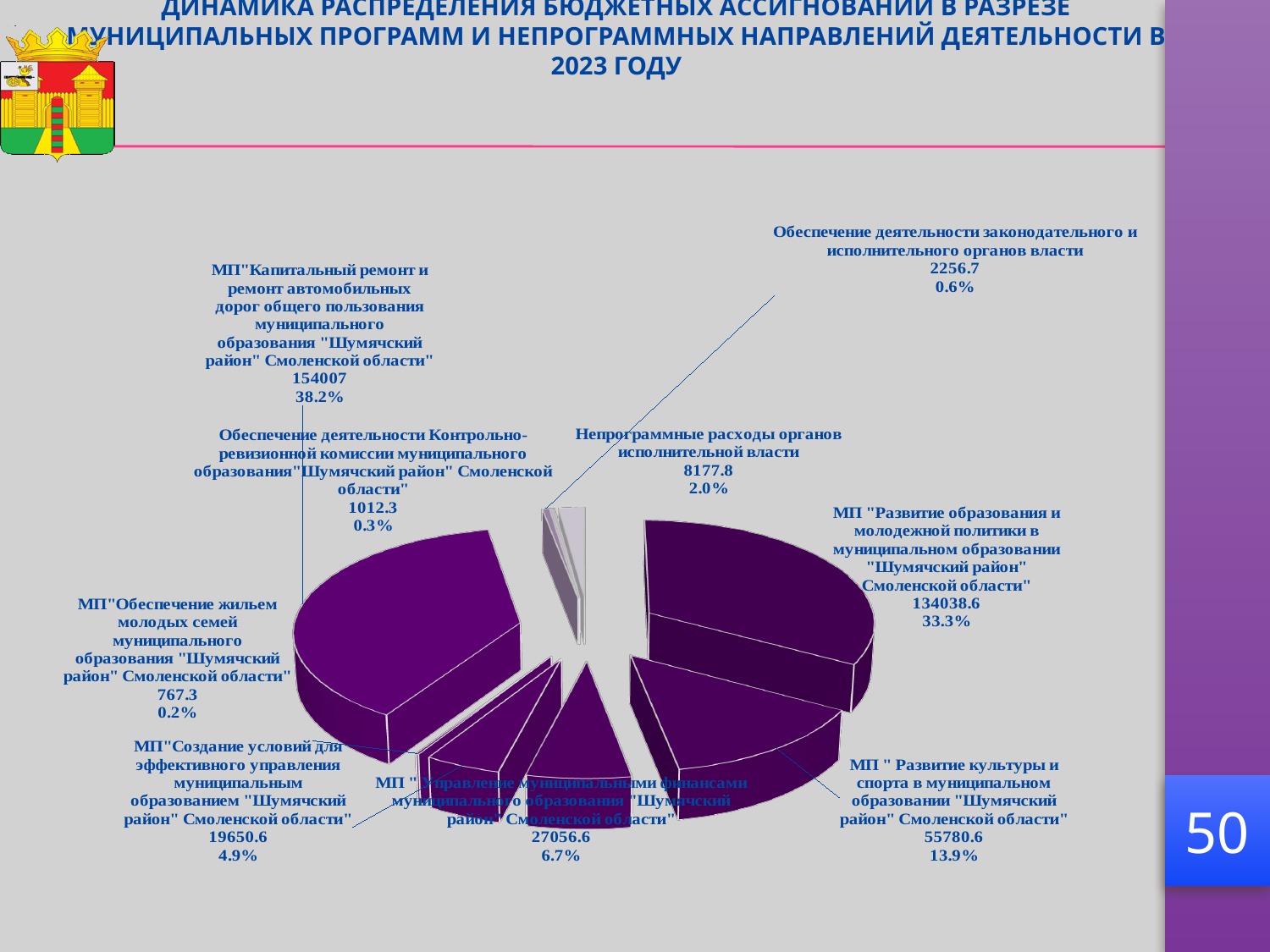
What is the difference in percentage share between МП "Капитальный ремонт" (38.2%) and МП "Развитие образования" (33.3%)? 4.9% How many slices (categories) does the pie chart have? 9 Which is larger: the value for МП "Создание условий для эффективного управления" or for МП "Управление муниципальными финансами"? МП "Управление муниципальными финансами" What share of the pie does МП "Развитие культуры и спорта" have? 13.9% Which category has the smallest share of the pie? МП "Обеспечение жильем молодых семей" What value is shown for Непрограммные расходы органов исполнительной власти? 8177.8 What value is shown for МП "Развитие образования и молодежной политики"? 134038.6 What is the percentage share of МП "Управление муниципальными финансами"? 6.7% What value is shown for Обеспечение деятельности Контрольно-ревизионной комиссии? 1012.3 What kind of chart is shown on the slide? Pie chart Which category has the largest share of the pie? МП "Капитальный ремонт и ремонт автомобильных дорог общего пользования" Which year does the chart title refer to? 2023